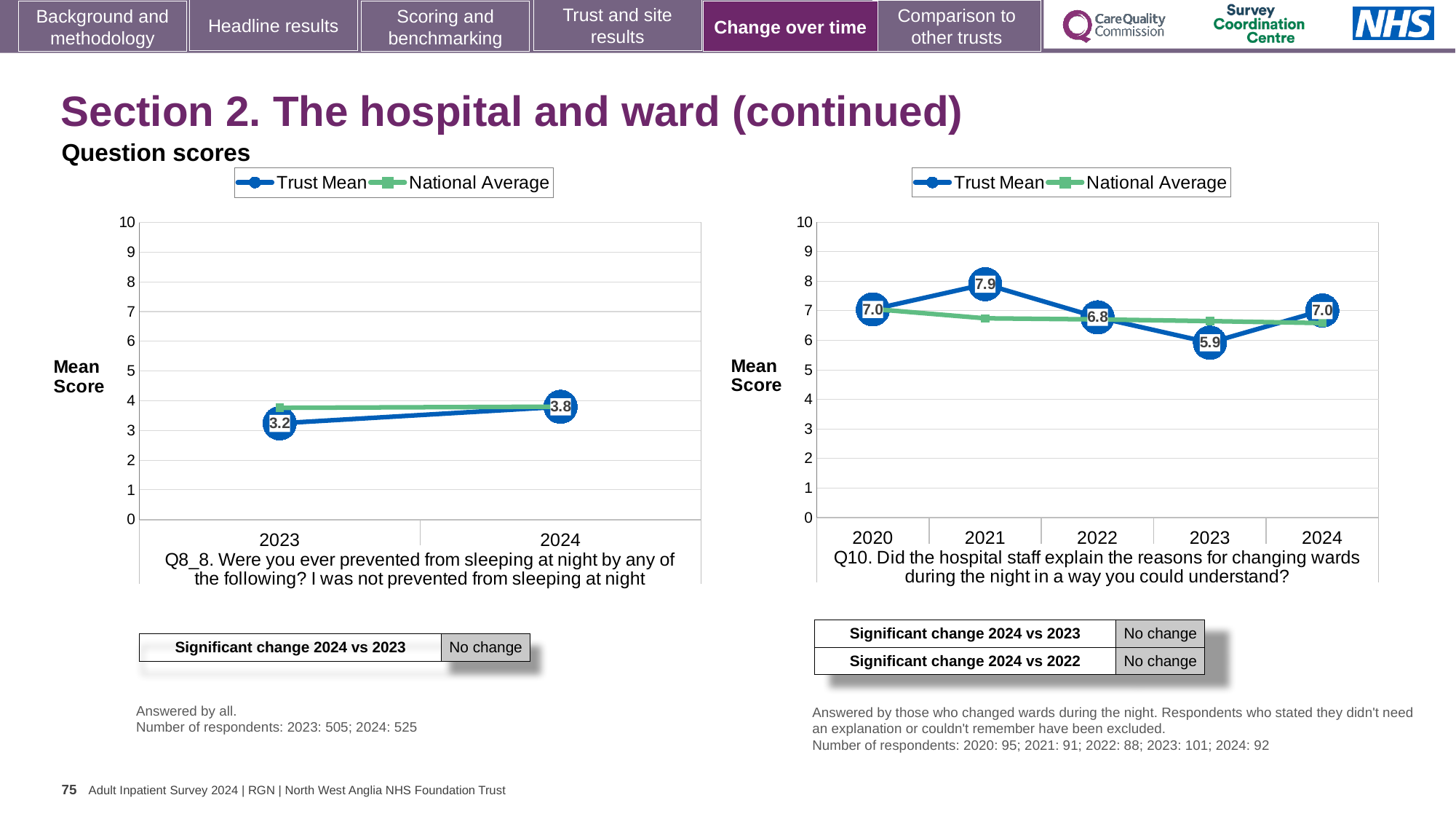
In the Q10 chart on the right, which year has the lowest Trust Mean? 2023 What type of chart is the Q10 chart on the right? line chart In the Q10 chart on the right, what is the difference between the Trust Mean in 2021 and in 2023? 2.0 In the Q10 chart on the right, what is the Trust Mean for 2023? 5.9 In the Q8_8 chart on the left, by how much did the Trust Mean change from 2023 to 2024? 0.6 In the Q10 chart on the right, what is the Trust Mean for 2021? 7.9 In the Q10 chart on the right, which year has the highest Trust Mean? 2021 In the Q8_8 chart on the left, what is the Trust Mean for 2024? 3.8 In the Q8_8 chart on the left, what is the Trust Mean for 2023? 3.2 In the Q10 chart on the right, how many years are plotted on the x axis? 5 In the Q8_8 chart on the left, does the Trust Mean rise or fall from 2023 to 2024? rise In the Q8_8 chart on the left, is the National Average for 2023 greater or less than 3? greater